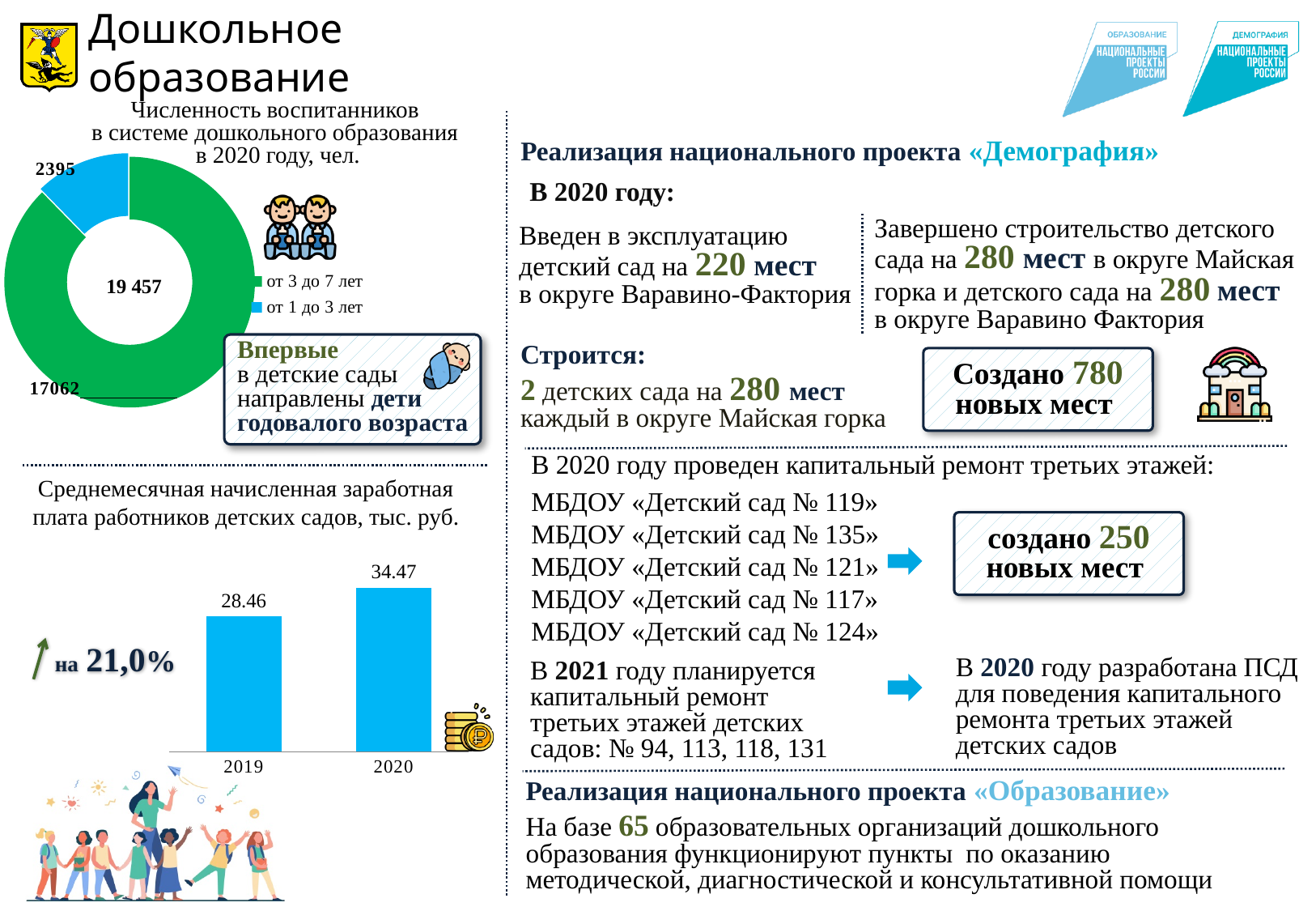
In the doughnut chart 'Численность воспитанников в системе дошкольного образования в 2020 году', what is the value for 'от 3 до 7 лет'? 17062 In the doughnut chart 'Численность воспитанников в системе дошкольного образования в 2020 году', which category is the largest? от 3 до 7 лет In the doughnut chart 'Численность воспитанников в системе дошкольного образования в 2020 году', what total number is shown in the centre? 19 457 In the bar chart 'Среднемесячная начисленная заработная плата работников детских садов', what is the value for 2020? 34.47 In the bar chart 'Среднемесячная начисленная заработная плата работников детских садов', do the values rise or fall from 2019 to 2020? rise In the doughnut chart 'Численность воспитанников в системе дошкольного образования в 2020 году', what colour is the 'от 1 до 3 лет' segment? blue What type of chart is 'Численность воспитанников в системе дошкольного образования в 2020 году'? doughnut chart How many categories does the legend of the doughnut chart 'Численность воспитанников в системе дошкольного образования в 2020 году' list? 2 In the bar chart 'Среднемесячная начисленная заработная плата работников детских садов', what is the value for 2019? 28.46 In the bar chart 'Среднемесячная начисленная заработная плата работников детских садов', what is the difference between the 2020 and 2019 values? 6.01 In the doughnut chart 'Численность воспитанников в системе дошкольного образования в 2020 году', what is the value for 'от 1 до 3 лет'? 2395 What type of chart is 'Среднемесячная начисленная заработная плата работников детских садов'? bar chart